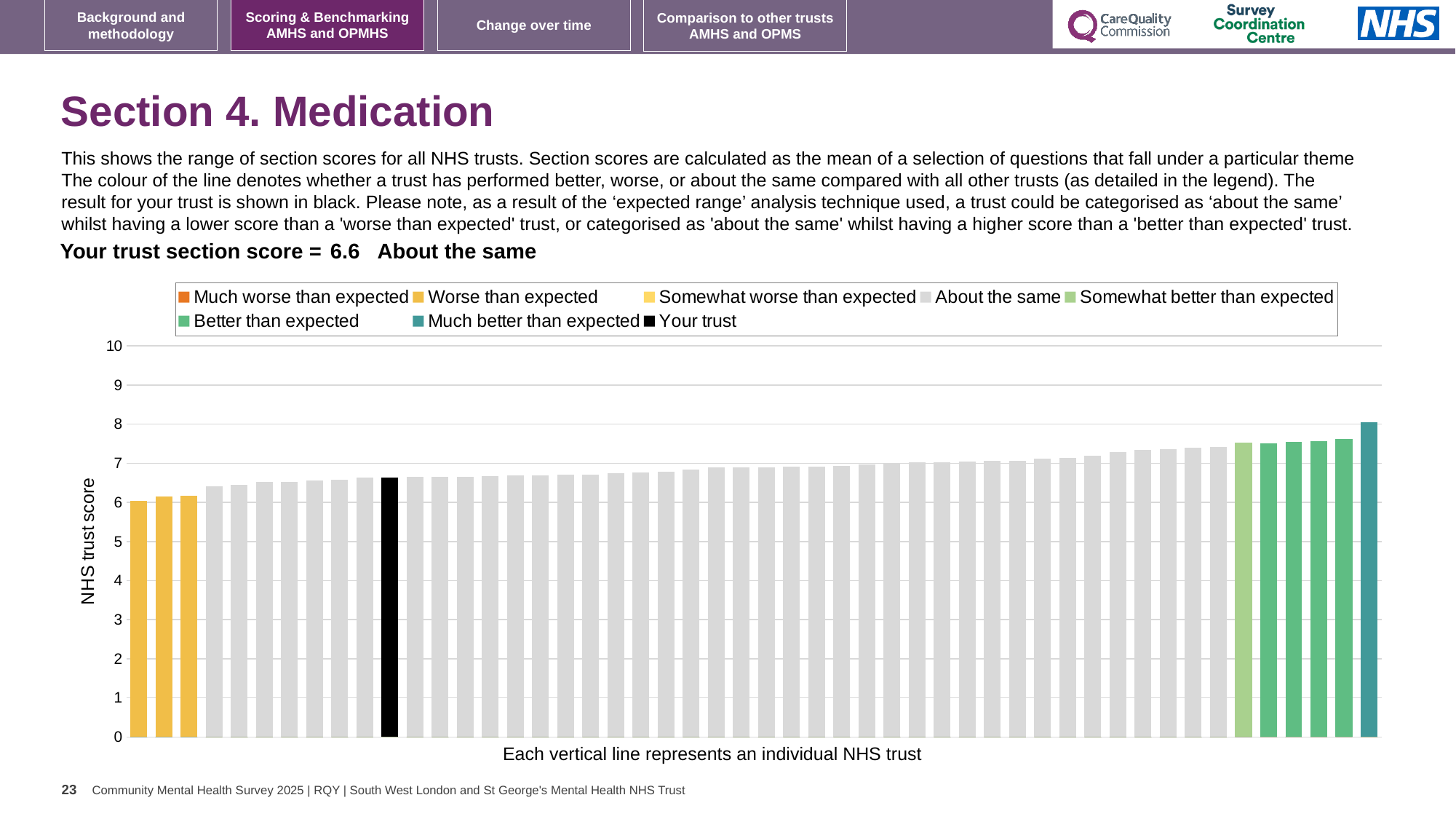
How many bars are coloured as 'Worse than expected'? 3 What is the label on the y axis of the chart? NHS trust score Do the bar values rise or fall from left to right along the x axis? rise What is the section score for your trust shown on the slide? 6.6 Is the value of the shortest bar greater or less than 7? less Is the value of the tallest bar greater or less than 7? greater Which category is your trust placed in for Section 4 Medication? About the same How many entries does the chart legend list? 8 How many bars are coloured as 'Better than expected'? 4 Is the value for your trust (the black bar) greater or less than 5? greater Which legend category does the tallest bar belong to? Much better than expected What kind of chart is shown on the slide? Bar chart